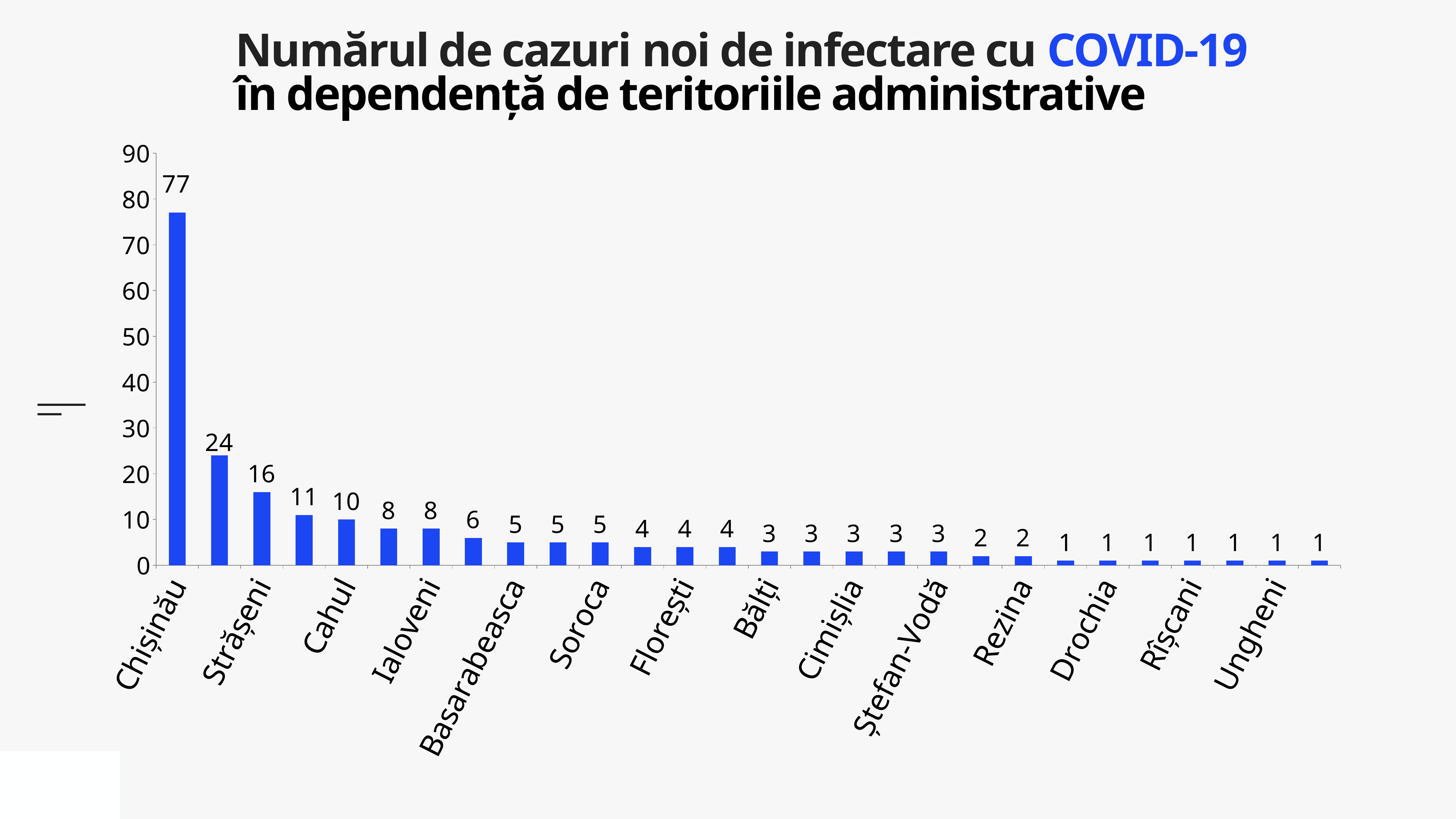
What is the value of the second bar from the left? 24 Which administrative territory has the highest number of new cases? Chișinău What is the highest tick value on the vertical axis? 90 What is the lowest value shown by any bar in the chart? 1 What is the difference between the first bar (77) and the second bar (24)? 53 How many bars are plotted in the chart? 28 What colour are the bars in the chart? blue How many bars have a value of 1? 7 Is the value for Chișinău greater or less than 70? greater What type of chart is shown on the slide? bar chart Do the values rise or fall moving from left to right along the x axis? fall What is the number of new COVID-19 cases for Chișinău? 77